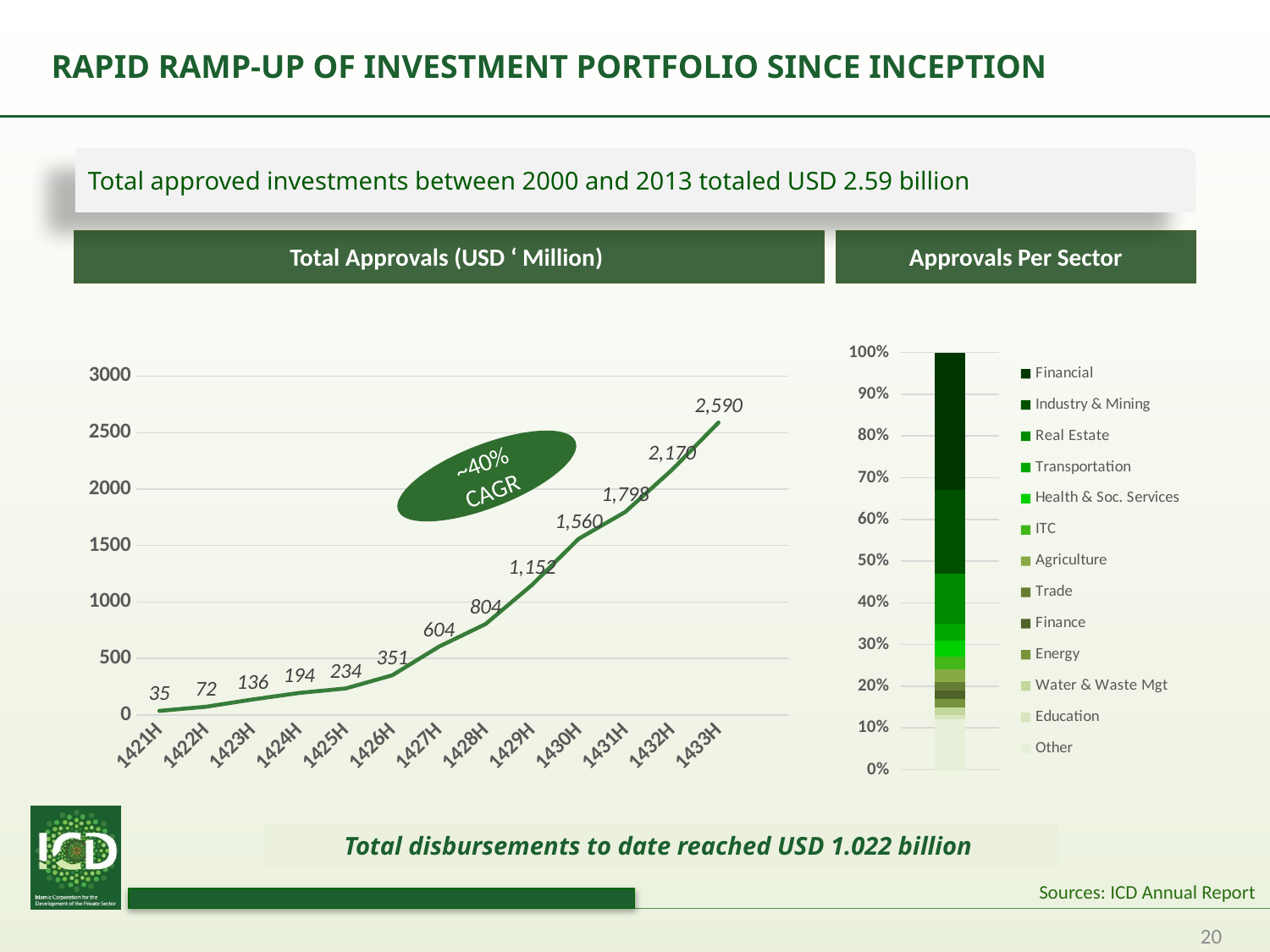
What kind of chart is the Total Approvals (USD ' Million) chart? Line chart In the Total Approvals (USD ' Million) chart, which year has the highest value? 1433H In the Total Approvals (USD ' Million) chart, which year has the lowest value? 1421H In the Total Approvals (USD ' Million) chart, how many years are plotted on the x axis? 13 How many sectors does the legend of the Approvals Per Sector chart list? 13 In the Total Approvals (USD ' Million) chart, what is the value for 1433H? 2,590 In the Total Approvals (USD ' Million) chart, what is the value for 1421H? 35 In the Total Approvals (USD ' Million) chart, what is the value for 1428H? 804 What CAGR is shown in the callout on the Total Approvals (USD ' Million) chart? ~40% In the Total Approvals (USD ' Million) chart, do the values rise or fall from 1421H to 1433H? Rise In the Total Approvals (USD ' Million) chart, what is the difference between the values for 1433H and 1432H? 420 In the Total Approvals (USD ' Million) chart, which is larger, the value for 1427H or the value for 1426H? 1427H